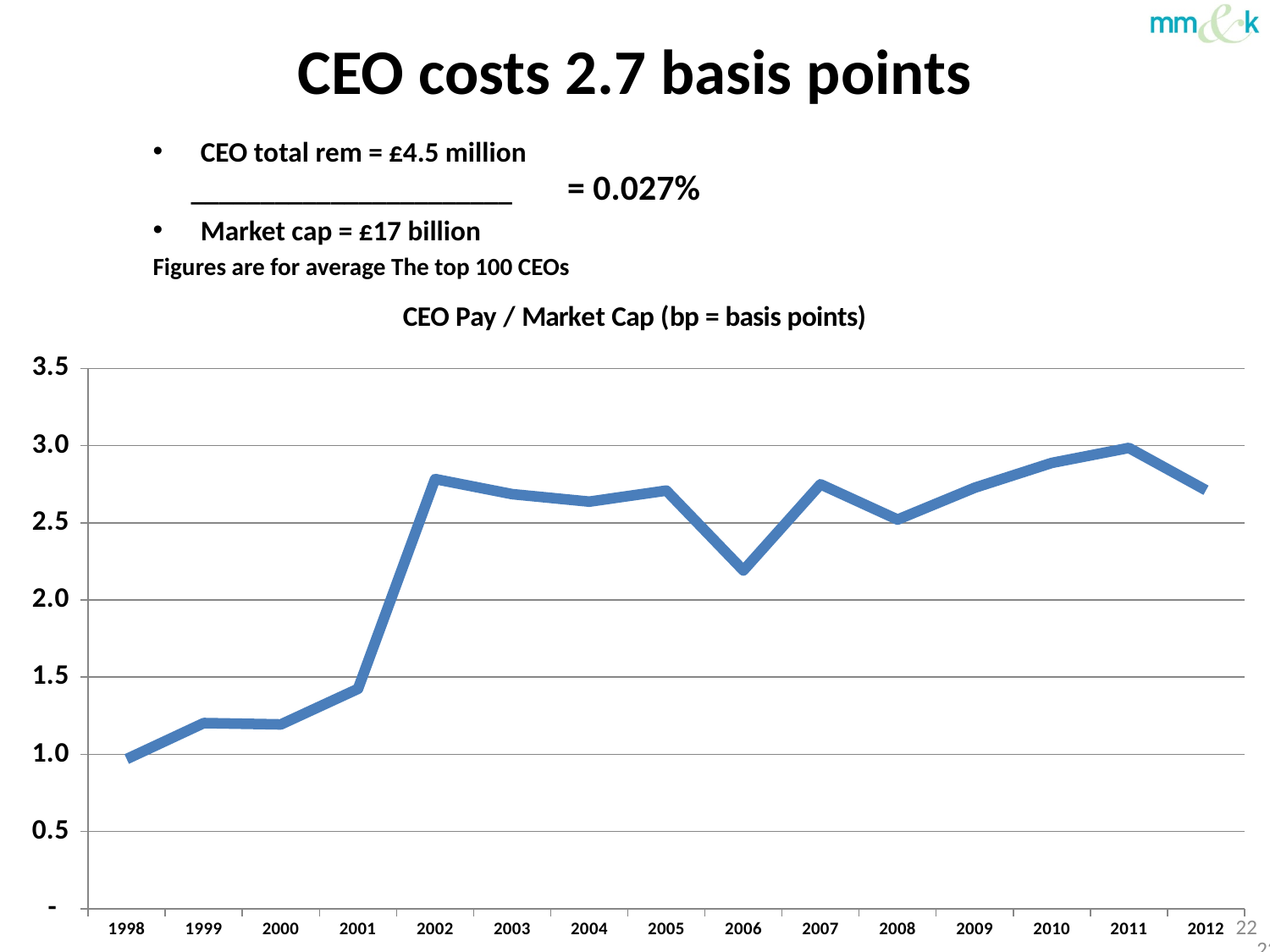
What is the title of the chart? CEO Pay / Market Cap (bp = basis points) What kind of chart is shown on the slide? Line chart Which year has the larger value, 2001 or 2002? 2002 How many years are plotted on the x axis of the chart? 15 Which year has the highest value on the chart? 2011 Overall, do the values rise or fall from 1998 to 2012? Rise Is the value for 2006 greater or less than 2.5? less Which year has the larger value, 2006 or 2007? 2007 Is the value for 1999 greater or less than 1.0? greater Is the value for 2001 greater or less than 1.5? less Which year has the lowest value on the chart? 1998